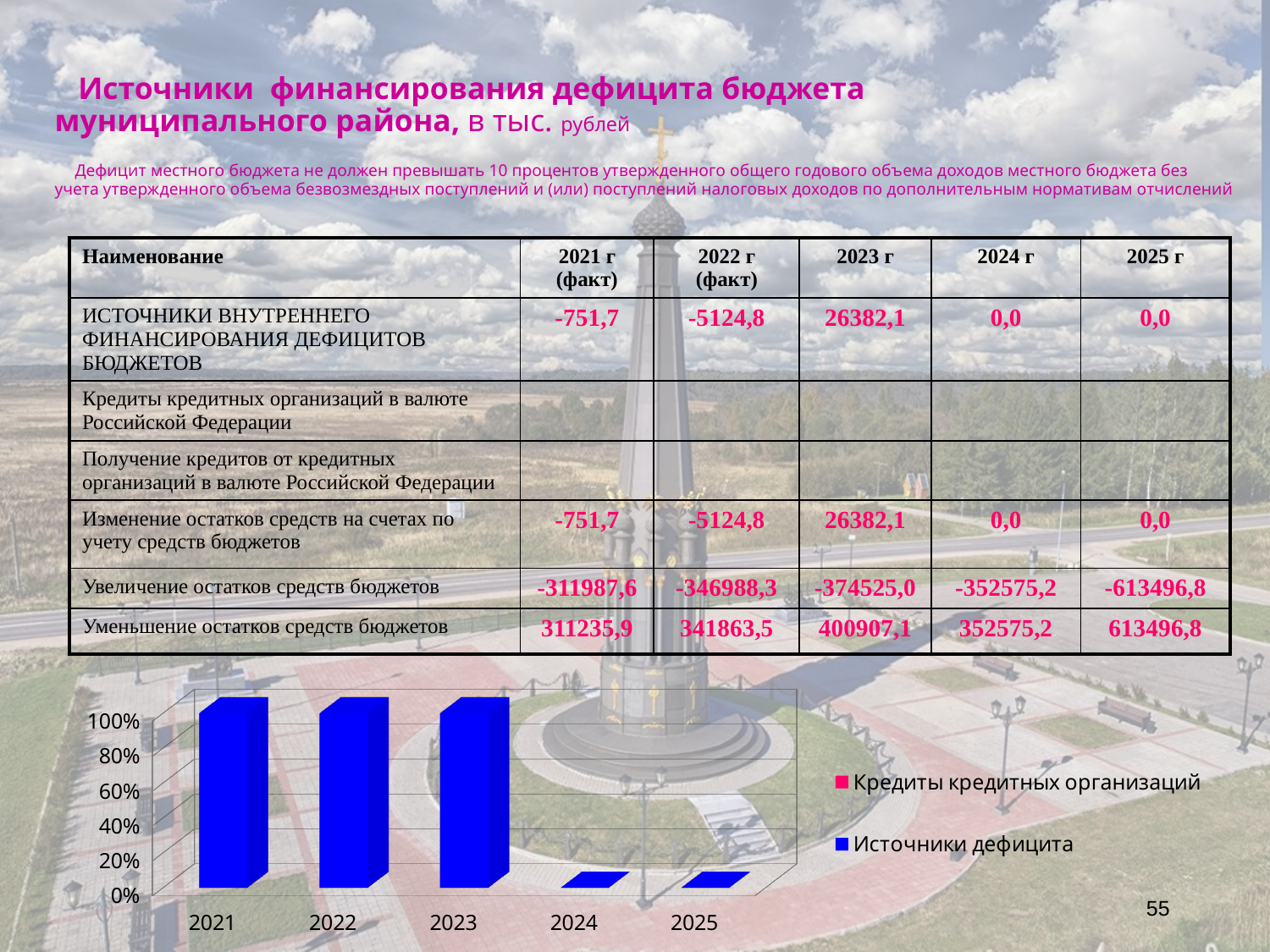
What kind of chart is shown at the bottom of the slide? bar chart In the bar chart, is the value for 2024 greater or less than 20%? less In the bar chart, is the value for 2023 greater or less than 60%? greater Which series is shown in blue in the bar chart? Источники дефицита In the bar chart, is the value for 2021 greater or less than 80%? greater In the bar chart, which is larger, the bar for 2022 or the bar for 2024? 2022 How many series does the legend of the bar chart list? 2 Which series is shown in pink in the bar chart legend? Кредиты кредитных организаций How many categories are shown on the x axis of the bar chart? 5 In the bar chart, which is larger, the bar for 2023 or the bar for 2025? 2023 What is the first category on the x axis of the bar chart? 2021